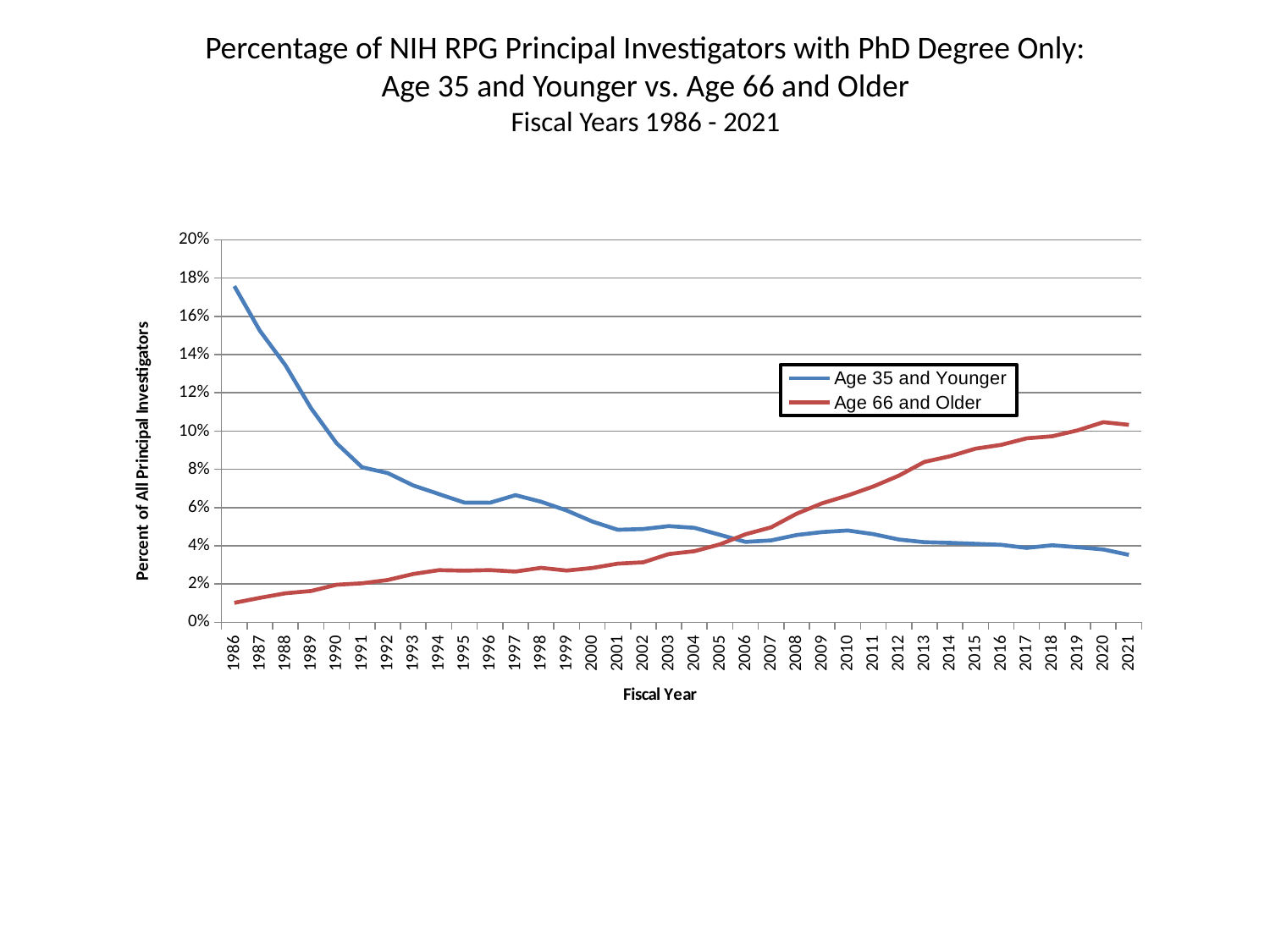
Is the value for Age 66 and Older in 1986 greater or less than 2%? less Is the value for Age 66 and Older in 2020 greater or less than 10%? greater Does the Age 66 and Older line rise or fall from 1986 to 2021? Rise How many series does the legend list? 2 How many fiscal years are plotted along the x axis? 36 What kind of chart is shown on the slide? Line chart Which series has the higher value in 2021, Age 35 and Younger or Age 66 and Older? Age 66 and Older Does the Age 35 and Younger line rise or fall from 1986 to 2021? Fall What is the title of the x axis? Fiscal Year In which fiscal year is the Age 35 and Younger series at its highest? 1986 Is the value for Age 35 and Younger in 1986 greater or less than 16%? greater Which series has the higher value in 1986, Age 35 and Younger or Age 66 and Older? Age 35 and Younger